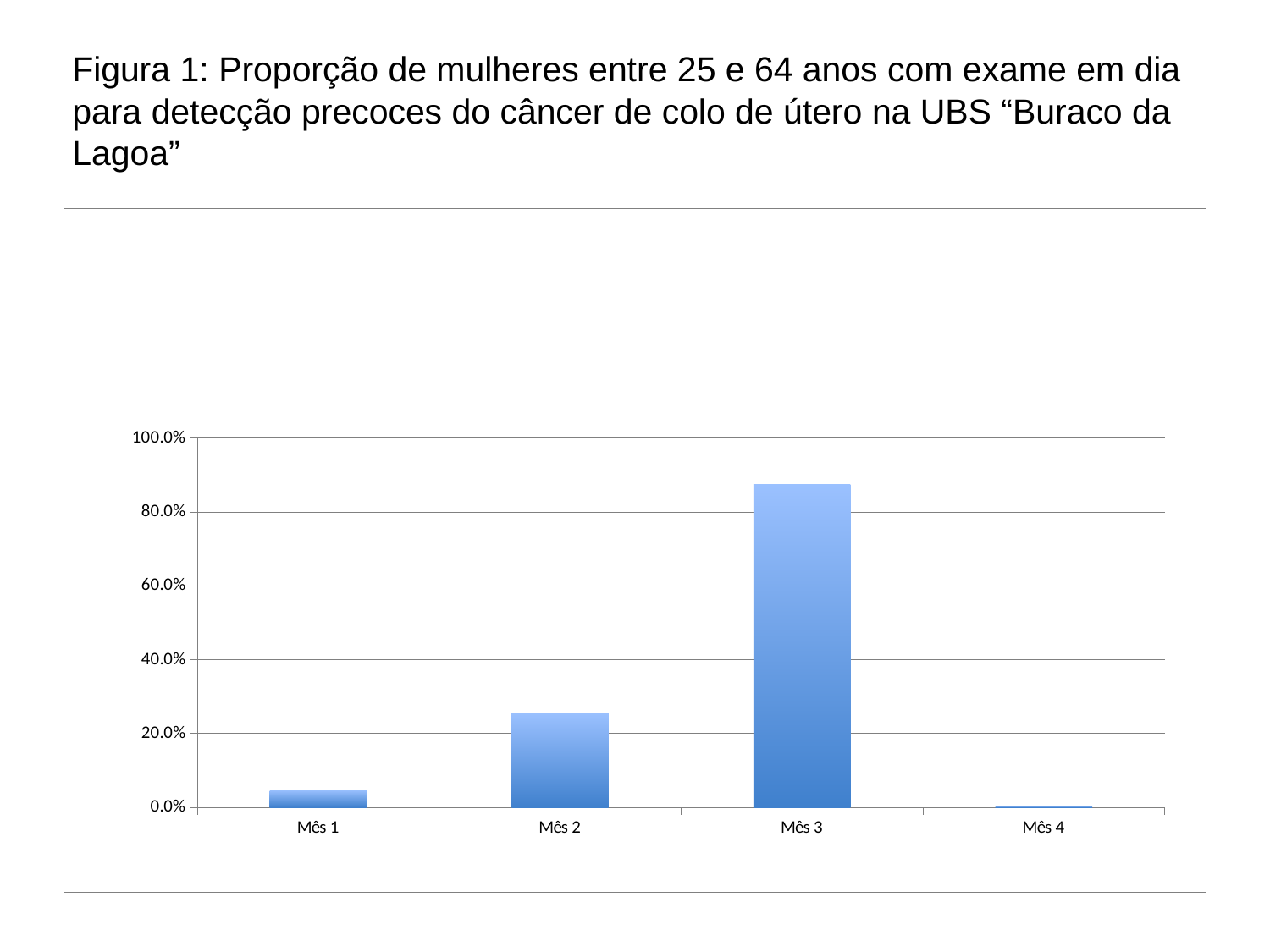
Which month has the highest value? Mês 3 What kind of chart is shown on the slide? bar chart Is the value for Mês 2 greater or less than 20.0%? greater Is the value for Mês 2 greater or less than 40.0%? less What is the highest value shown on the y axis? 100.0% What is the figure number given in the slide title? Figura 1 Is the value for Mês 1 greater or less than 20.0%? less Which is larger, the value for Mês 2 or the value for Mês 1? Mês 2 Which month has the lowest value? Mês 4 Do the values rise or fall from Mês 1 to Mês 3? rise How many categories (months) are shown on the x axis? 4